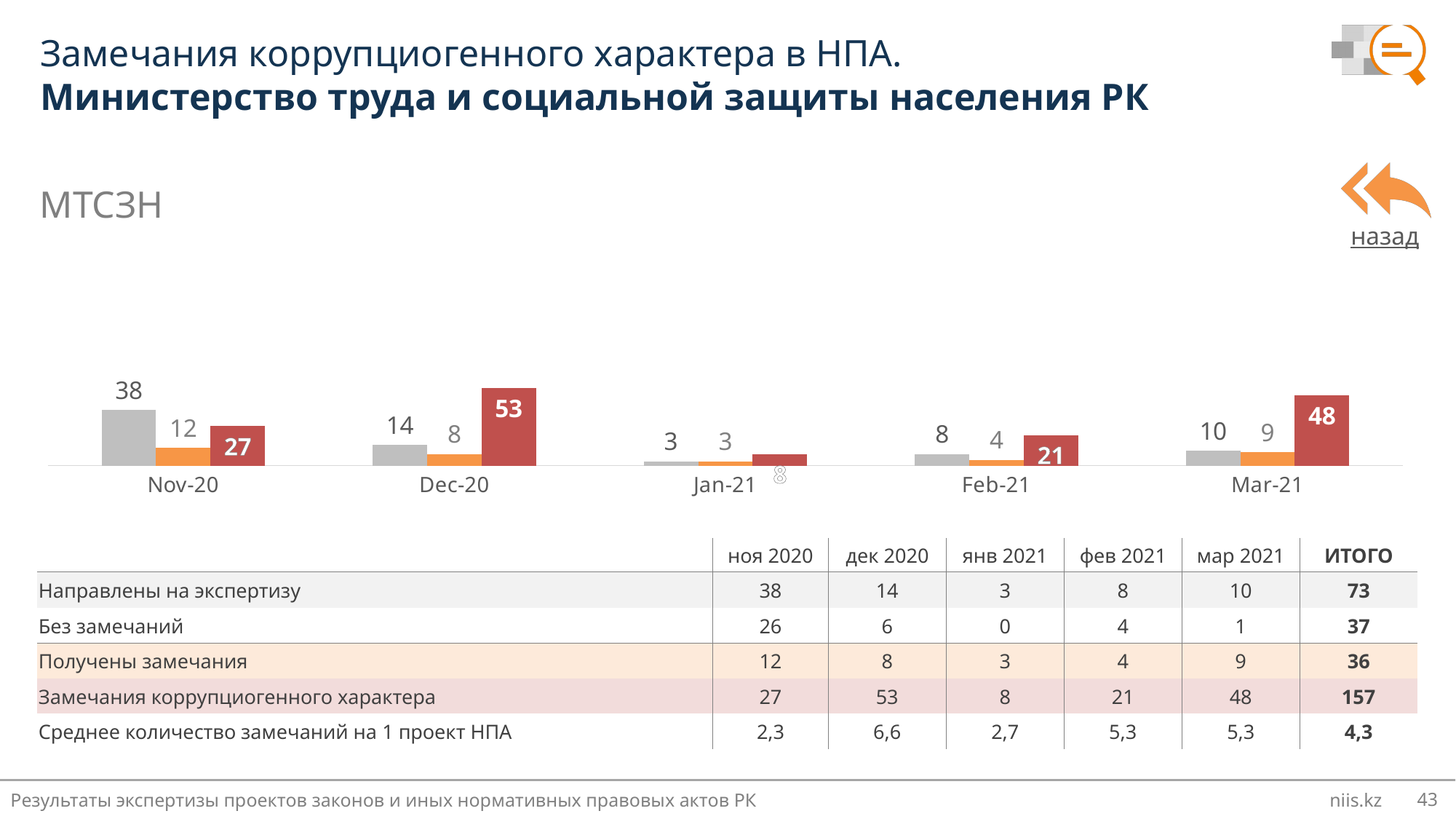
What is the value of the grey bar for Nov-20? 38 What is the value of the red bar for Jan-21? 8 What is the value of the red bar for Dec-20? 53 In which month is the grey bar the lowest? Jan-21 What type of chart is shown on the slide? bar chart In which month is the red bar the highest? Dec-20 How many differently coloured bar series are plotted for each month in the chart? 3 Which is larger: the grey bar for Nov-20 or the red bar for Nov-20? the grey bar (38) What is the difference between the red bar values for Mar-21 and Feb-21? 27 Do the grey bar values rise or fall from Nov-20 to Jan-21? fall What is the value of the orange bar for Mar-21? 9 How many months (categories) are shown on the x axis of the chart? 5